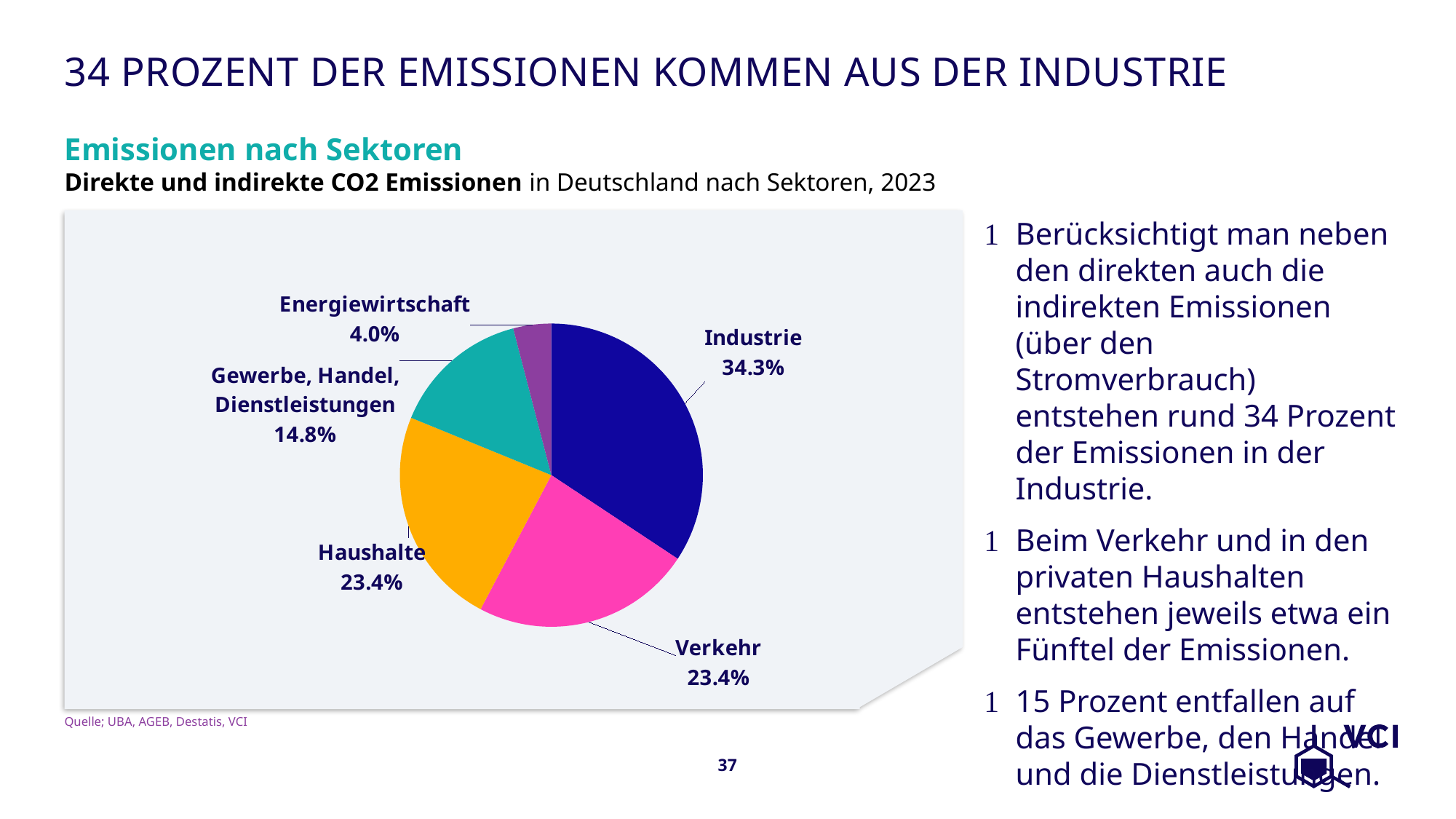
Which has a larger share, Haushalte or Gewerbe, Handel, Dienstleistungen? Haushalte What share of emissions is attributed to Energiewirtschaft? 4.0% What percentage is shown for Gewerbe, Handel, Dienstleistungen? 14.8% Which sector has the smallest share of emissions in the pie chart? Energiewirtschaft What is the difference in percentage points between Industrie and Verkehr? 10.9 What is the difference in percentage points between Gewerbe, Handel, Dienstleistungen and Energiewirtschaft? 10.8 What type of chart is shown on the slide? Pie chart What share of emissions does the Industrie slice represent? 34.3% What percentage is shown for Haushalte? 23.4% What is the title of the chart? Emissionen nach Sektoren How many sectors are shown in the pie chart? 5 Which sector has the largest share of emissions in the pie chart? Industrie